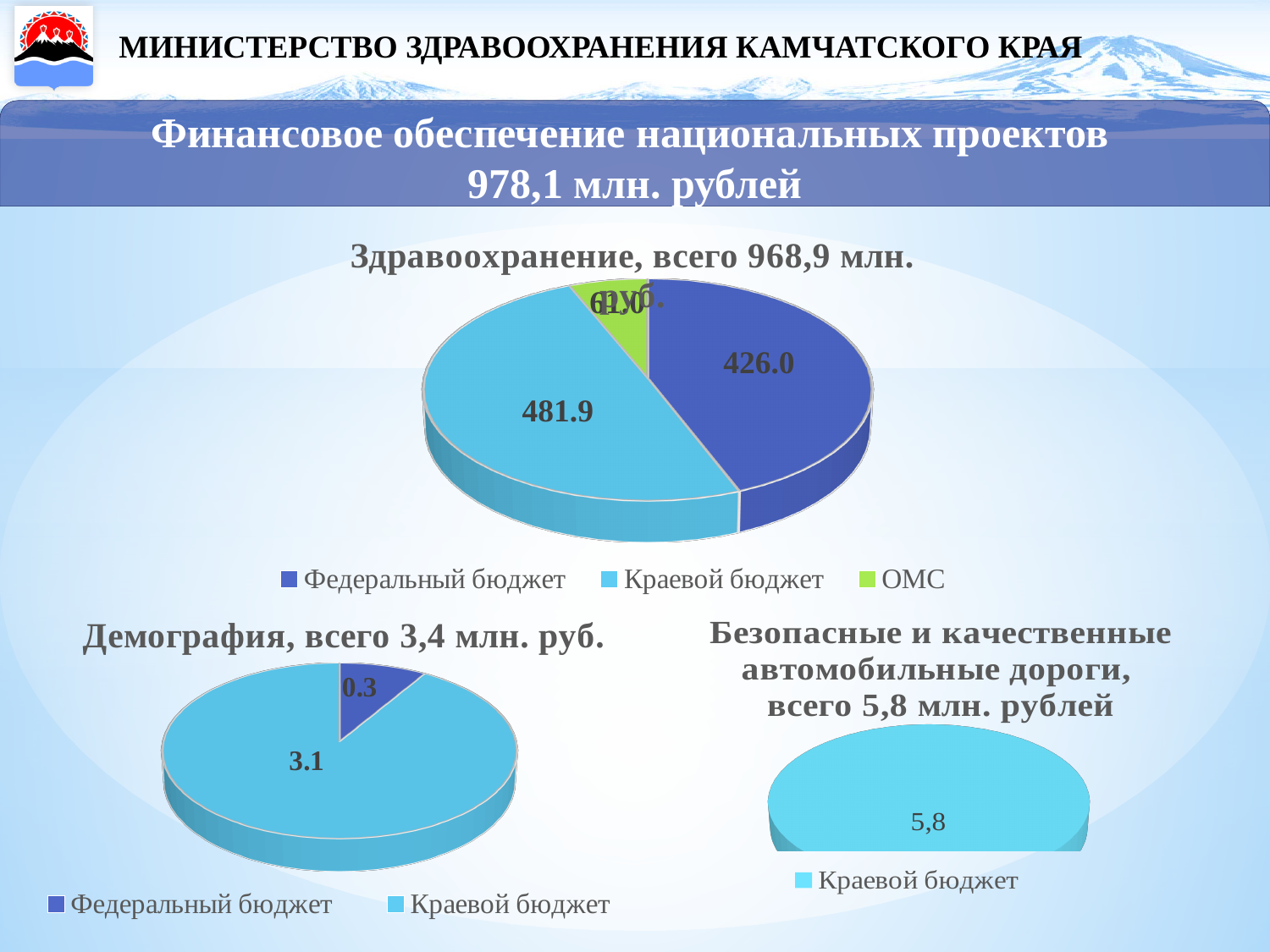
What kind of chart is the "Здравоохранение, всего 968,9 млн. руб." chart? pie chart In the "Демография, всего 3,4 млн. руб." chart, what is the value for Федеральный бюджет? 0.3 In the "Здравоохранение, всего 968,9 млн. руб." chart, what is the value for Краевой бюджет? 481.9 In the "Демография, всего 3,4 млн. руб." chart, what is the difference between Краевой бюджет and Федеральный бюджет? 2.8 In the "Здравоохранение, всего 968,9 млн. руб." chart, which is larger: Федеральный бюджет or Краевой бюджет? Краевой бюджет In the "Здравоохранение, всего 968,9 млн. руб." chart, which category has the largest slice? Краевой бюджет In the "Безопасные и качественные автомобильные дороги, всего 5,8 млн. рублей" chart, what is the value for Краевой бюджет? 5,8 In the "Здравоохранение, всего 968,9 млн. руб." chart, what is the difference between Краевой бюджет and Федеральный бюджет? 55.9 In the "Здравоохранение, всего 968,9 млн. руб." chart, what is the value for Федеральный бюджет? 426.0 How many entries does the legend of the "Здравоохранение, всего 968,9 млн. руб." chart list? 3 In the "Демография, всего 3,4 млн. руб." chart, what is the value for Краевой бюджет? 3.1 In the "Здравоохранение, всего 968,9 млн. руб." chart, which category has the smallest slice? ОМС